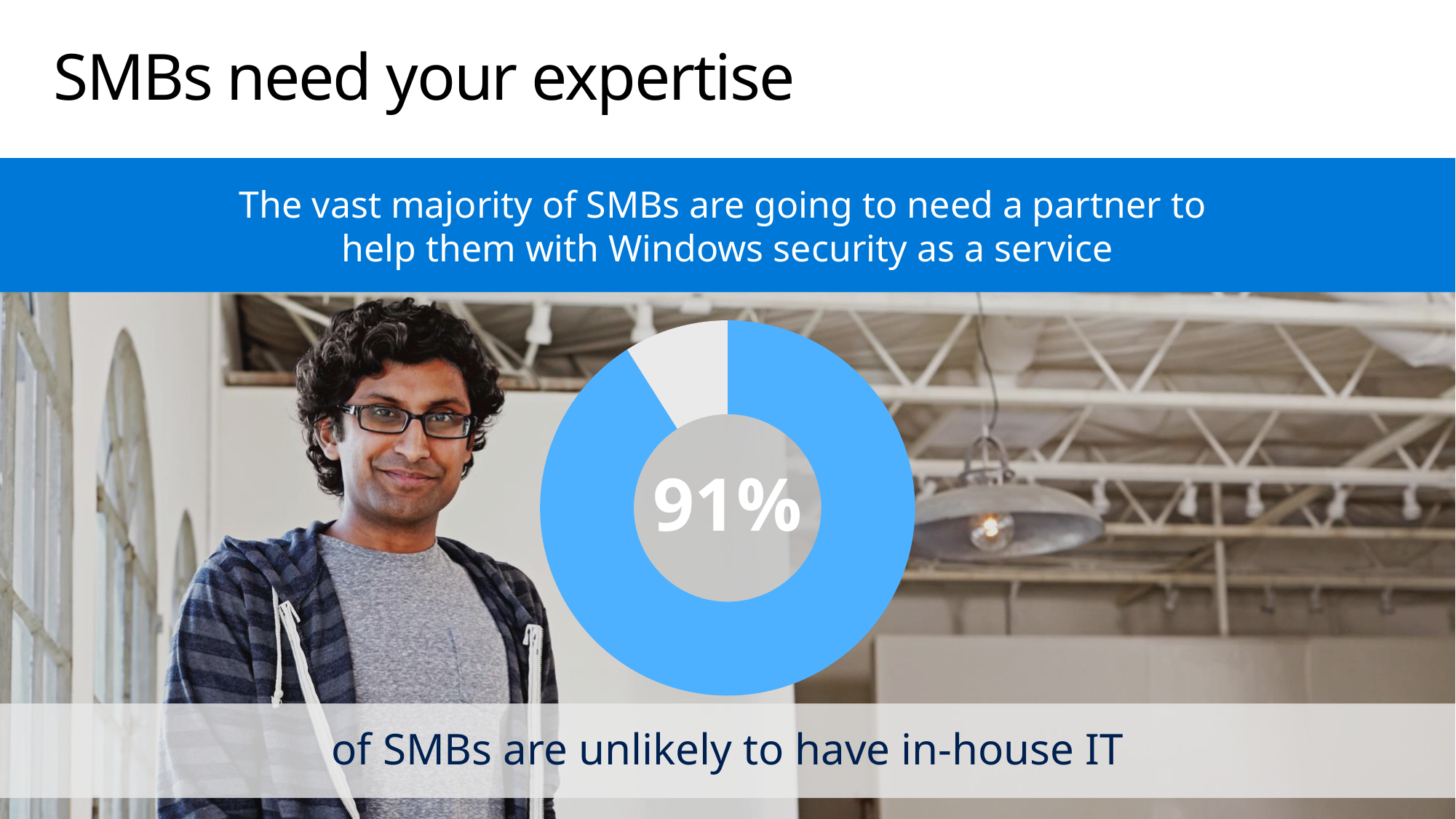
What colour is the largest slice of the donut chart? blue What percentage is printed in the centre of the donut chart? 91% What share of the donut chart does the blue slice represent? 91% Is the value shown in the donut chart greater or less than 50%? greater What kind of chart is shown on the slide? donut chart What share of the donut chart does the light grey slice represent? 9% According to the slide, what does the 91% in the donut chart represent? SMBs that are unlikely to have in-house IT Which slice of the donut chart is larger, the blue one or the light grey one? the blue one How many slices does the donut chart have? 2